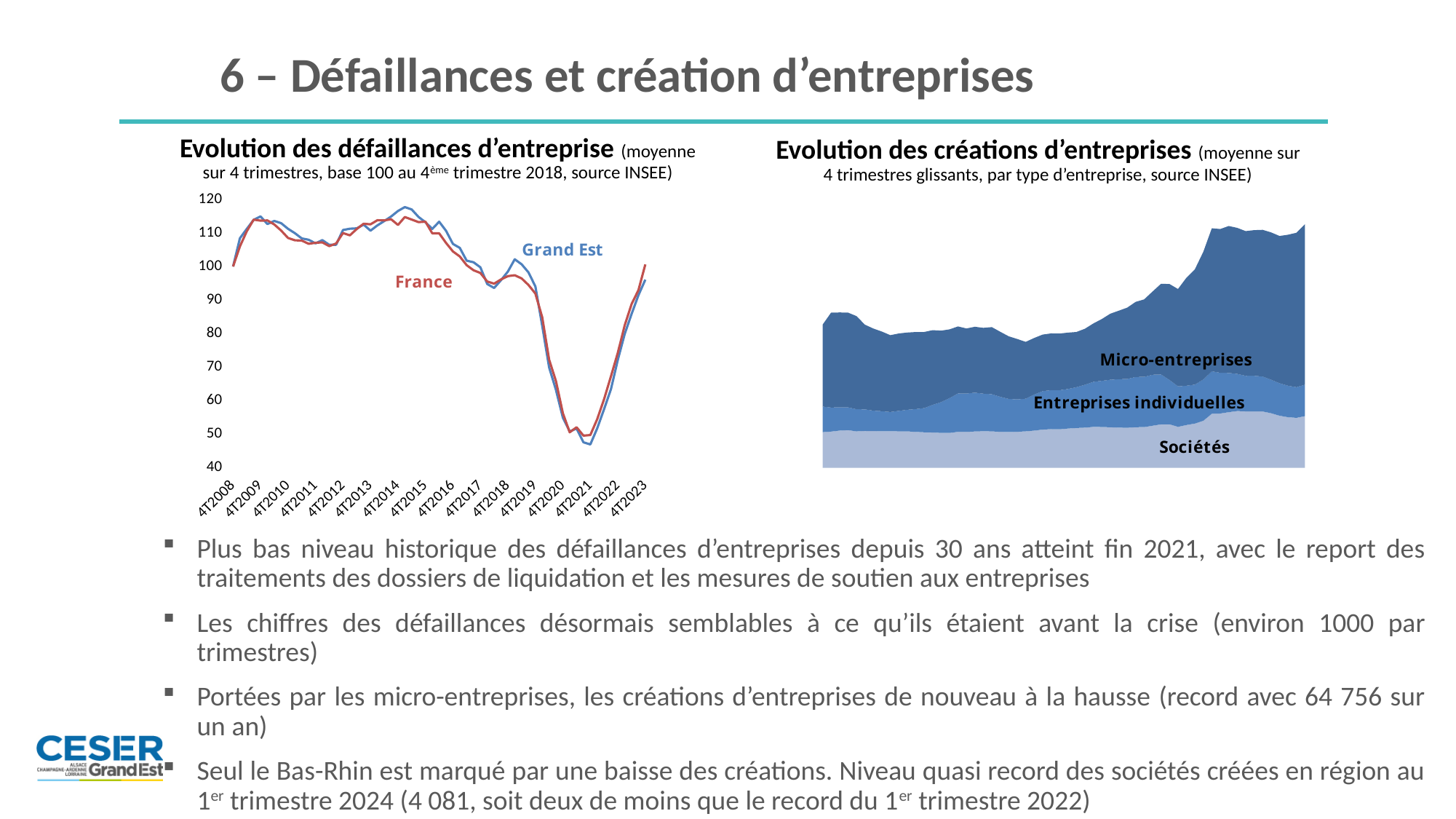
How many series are shown in the 'Evolution des créations d'entreprises' chart? 3 How many series are plotted in the 'Evolution des défaillances d'entreprise' chart? 2 In the 'Evolution des défaillances d'entreprise' chart, what colour is the France line? Red In the 'Evolution des défaillances d'entreprise' chart, do the values rise or fall between 4T2019 and 4T2021? fall What kind of chart is 'Evolution des créations d'entreprises'? Stacked area chart In the 'Evolution des créations d'entreprises' chart, which series is at the bottom of the stack? Sociétés In the 'Evolution des défaillances d'entreprise' chart, is the Grand Est value at 4T2021 greater or less than 50? less In the 'Evolution des défaillances d'entreprise' chart, do the values rise or fall between 4T2021 and 4T2023? rise In the 'Evolution des défaillances d'entreprise' chart, is the Grand Est value at 4T2014 greater or less than 110? greater How many x-axis labels are shown on the 'Evolution des défaillances d'entreprise' chart? 16 In the 'Evolution des défaillances d'entreprise' chart, at which period does the Grand Est series reach its lowest value? 4T2021 What kind of chart is 'Evolution des défaillances d'entreprise'? Line chart